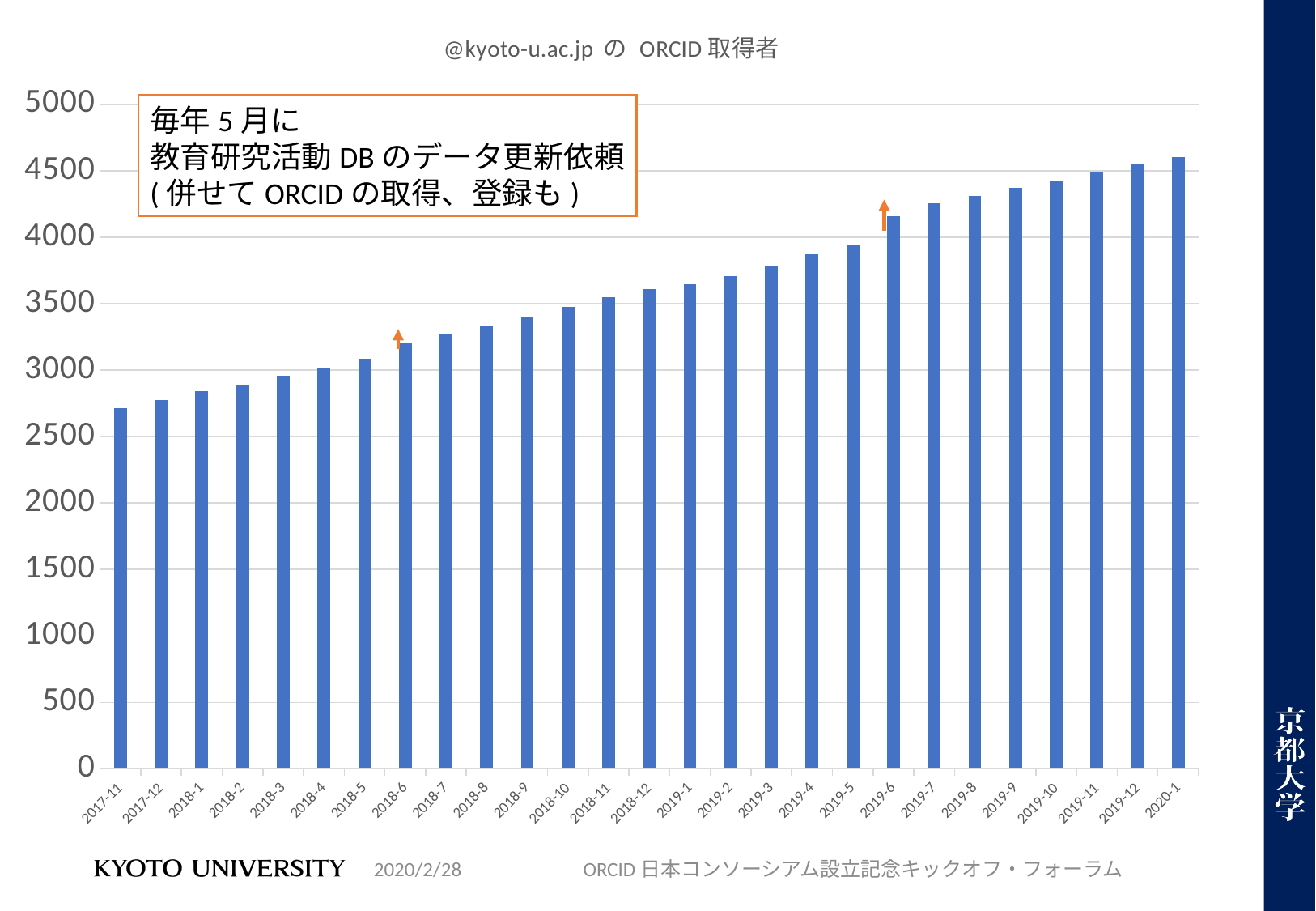
What is the highest value shown on the vertical axis? 5000 Is the value for 2020-1 greater or less than 4500? greater How many months (bars) are plotted in the chart? 27 Which is larger, the value for 2018-6 or the value for 2019-6? 2019-6 Do the values rise or fall from 2017-11 to 2020-1? rise What is the title of the chart? @kyoto-u.ac.jp の ORCID 取得者 Is the value for 2018-6 greater or less than 3000? greater Which month has the highest value in the chart? 2020-1 What kind of chart is shown on the slide? bar chart Which month has the lowest value in the chart? 2017-11 Is the value for 2017-11 greater or less than 3000? less